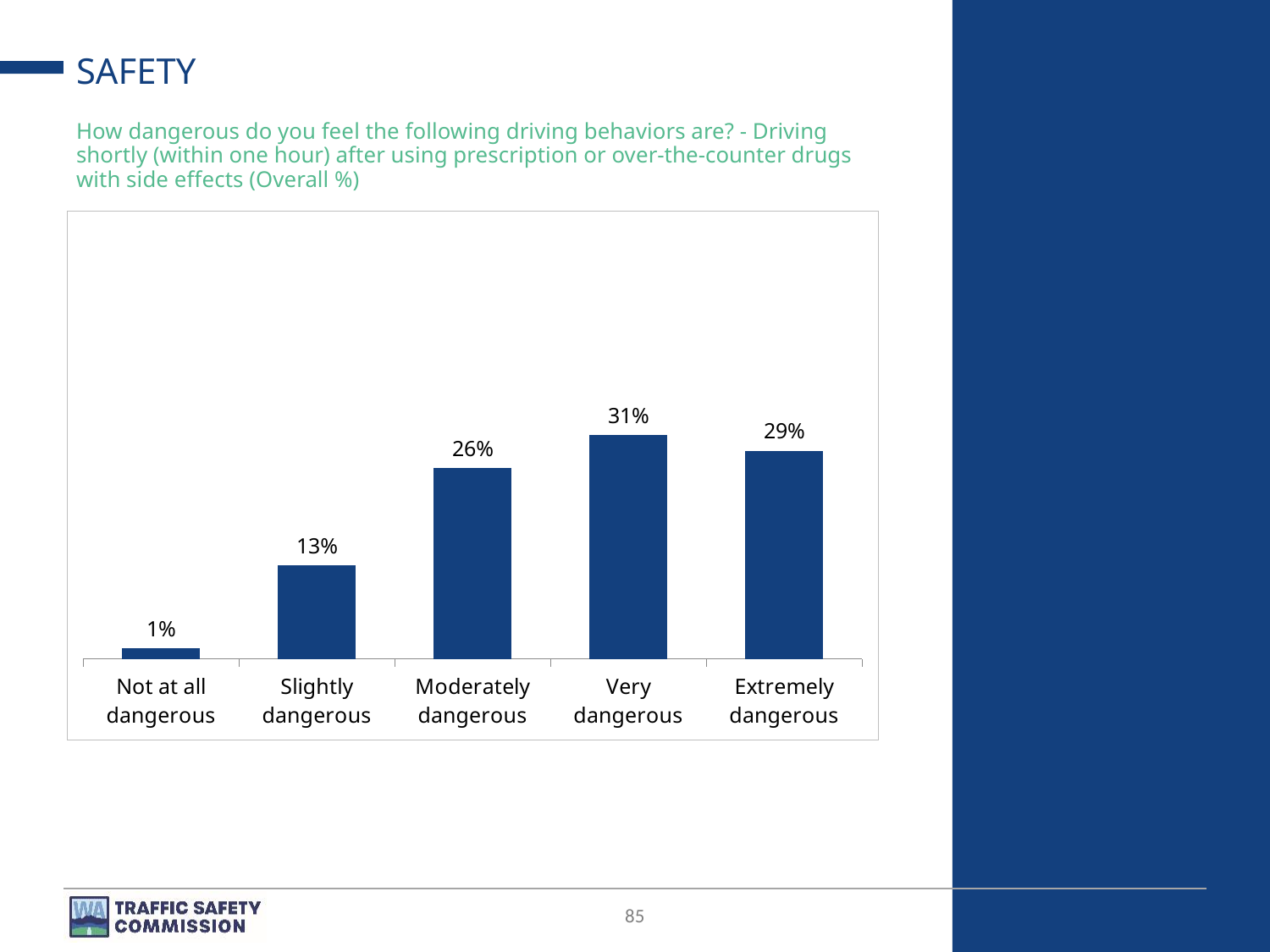
What is the value shown for "Slightly dangerous"? 13% Do the values rise or fall from "Not at all dangerous" to "Very dangerous"? Rise Which is larger, the value for "Extremely dangerous" or the value for "Moderately dangerous"? Extremely dangerous Which category has the lowest value? Not at all dangerous What is the difference between the "Very dangerous" and "Extremely dangerous" values? 2% Which category has the highest value? Very dangerous What is the difference between the "Moderately dangerous" and "Slightly dangerous" values? 13% What is the combined value of the "Very dangerous" and "Extremely dangerous" categories? 60% What is the value shown for "Not at all dangerous"? 1% What percentage of respondents rated driving shortly after using prescription or over-the-counter drugs with side effects as "Moderately dangerous"? 26% How many categories are shown on the x axis of the chart? 5 What kind of chart is shown on the slide? Bar chart